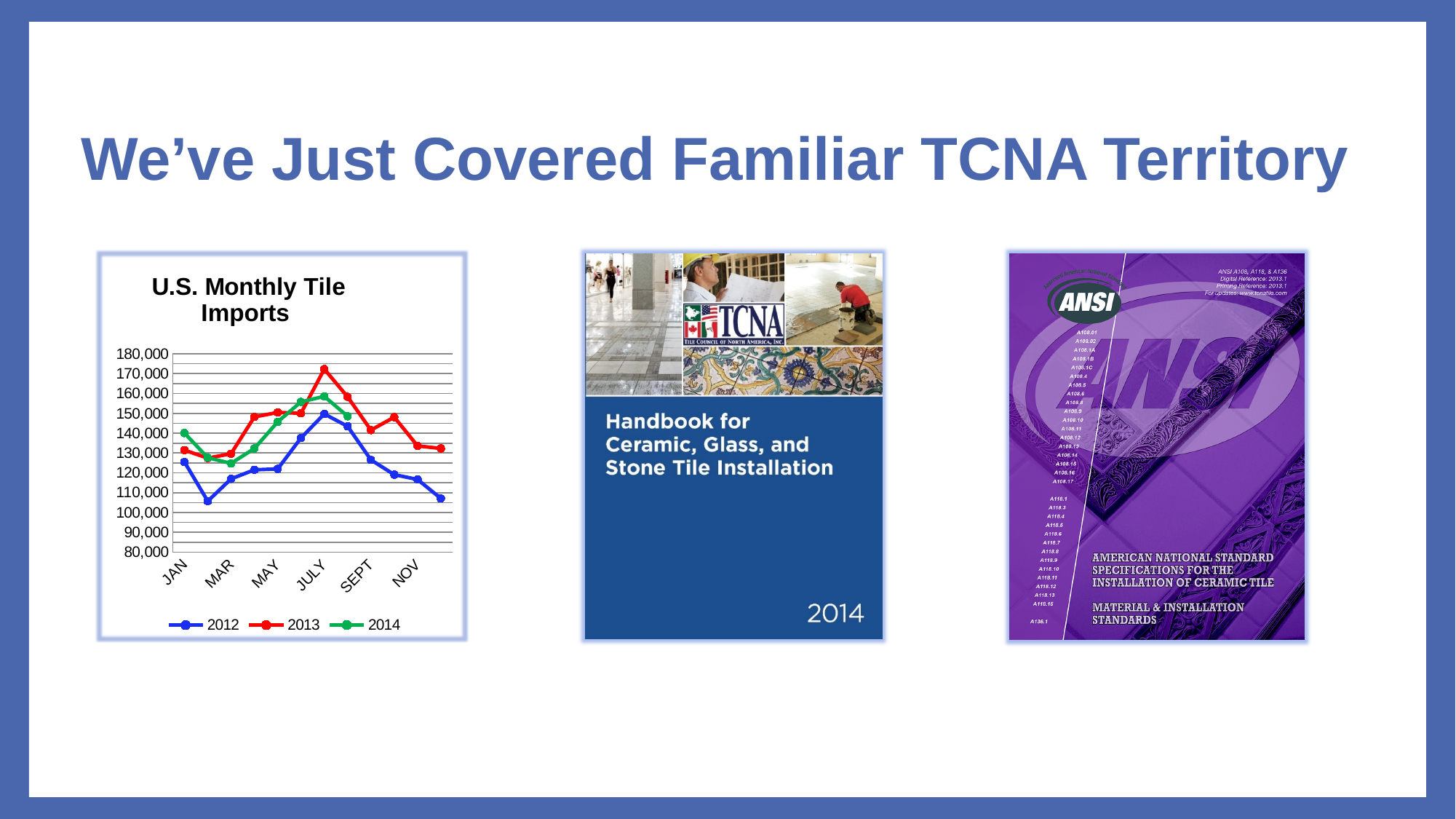
In the U.S. Monthly Tile Imports chart, is the last 2012 value (December) greater or less than 110,000? less In the U.S. Monthly Tile Imports chart, at which labeled month does the 2013 series reach its peak? JULY How many series does the legend of the U.S. Monthly Tile Imports chart list? 3 In the U.S. Monthly Tile Imports chart, which series contains the lowest point on the chart? 2012 Which years are listed in the legend of the U.S. Monthly Tile Imports chart? 2012, 2013, 2014 In the U.S. Monthly Tile Imports chart, is the 2014 value for JULY greater or less than 150,000? greater In the U.S. Monthly Tile Imports chart, is the 2012 value for JAN greater or less than 120,000? greater In the U.S. Monthly Tile Imports chart, which series reaches the highest value on the chart? 2013 In the U.S. Monthly Tile Imports chart, does the 2012 series rise or fall from JULY to the end of the year? fall What is the title of the line chart on the slide? U.S. Monthly Tile Imports What kind of chart is the U.S. Monthly Tile Imports chart? line chart In the U.S. Monthly Tile Imports chart, which is larger in JULY: the 2012 value or the 2013 value? 2013